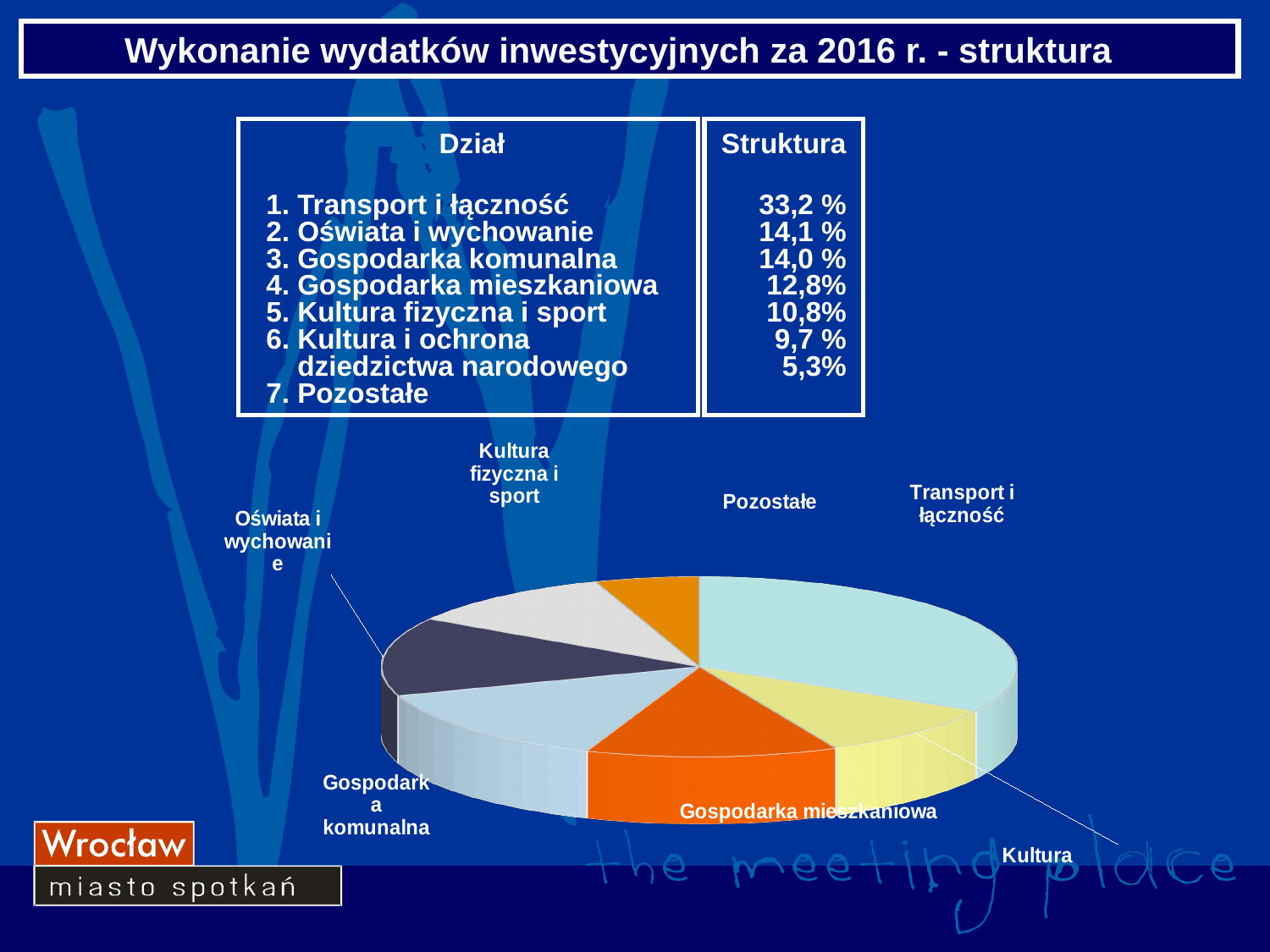
How many slices does the pie chart have? 7 What share of the pie does Transport i łączność have? 33,2 % What is the value shown for Gospodarka mieszkaniowa? 12,8% What kind of chart is shown on the slide? pie chart What is the value shown for Kultura fizyczna i sport? 10,8% Which category has the smallest share of the pie? Pozostałe Which is larger, the share for Transport i łączność or the share for Gospodarka mieszkaniowa? Transport i łączność What is the difference between the share for Transport i łączność and the share for Pozostałe? 27,9 % What colour is the Gospodarka mieszkaniowa slice of the pie? orange What is the title of the slide containing the pie chart? Wykonanie wydatków inwestycyjnych za 2016 r. - struktura What is the value shown for Pozostałe? 5,3% Which category has the largest share of the pie? Transport i łączność